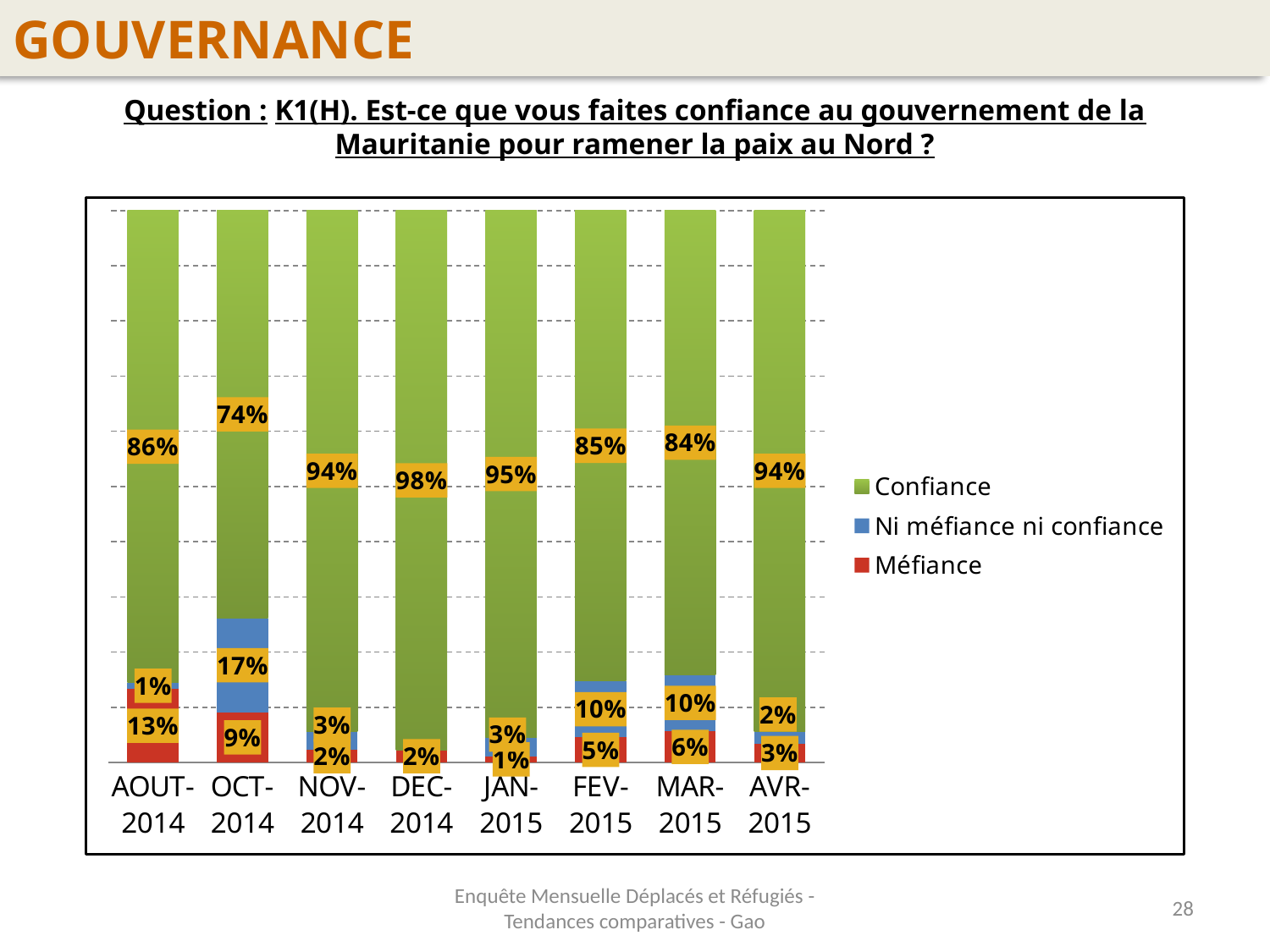
Which legend entry is shown in red? Méfiance How many months are shown on the x axis? 8 What is the Confiance value for DEC-2014? 98% Which month has the highest Confiance value? DEC-2014 What is the Ni méfiance ni confiance value for OCT-2014? 17% How many series does the legend list? 3 Does the Confiance value rise or fall from AOUT-2014 to OCT-2014? fall What is the difference between the Confiance values for DEC-2014 and OCT-2014? 24% What is the Méfiance value for AOUT-2014? 13% What kind of chart is shown on the slide? stacked bar chart Which is larger, the Méfiance value for MAR-2015 or for FEV-2015? MAR-2015 Which month has the lowest Confiance value? OCT-2014